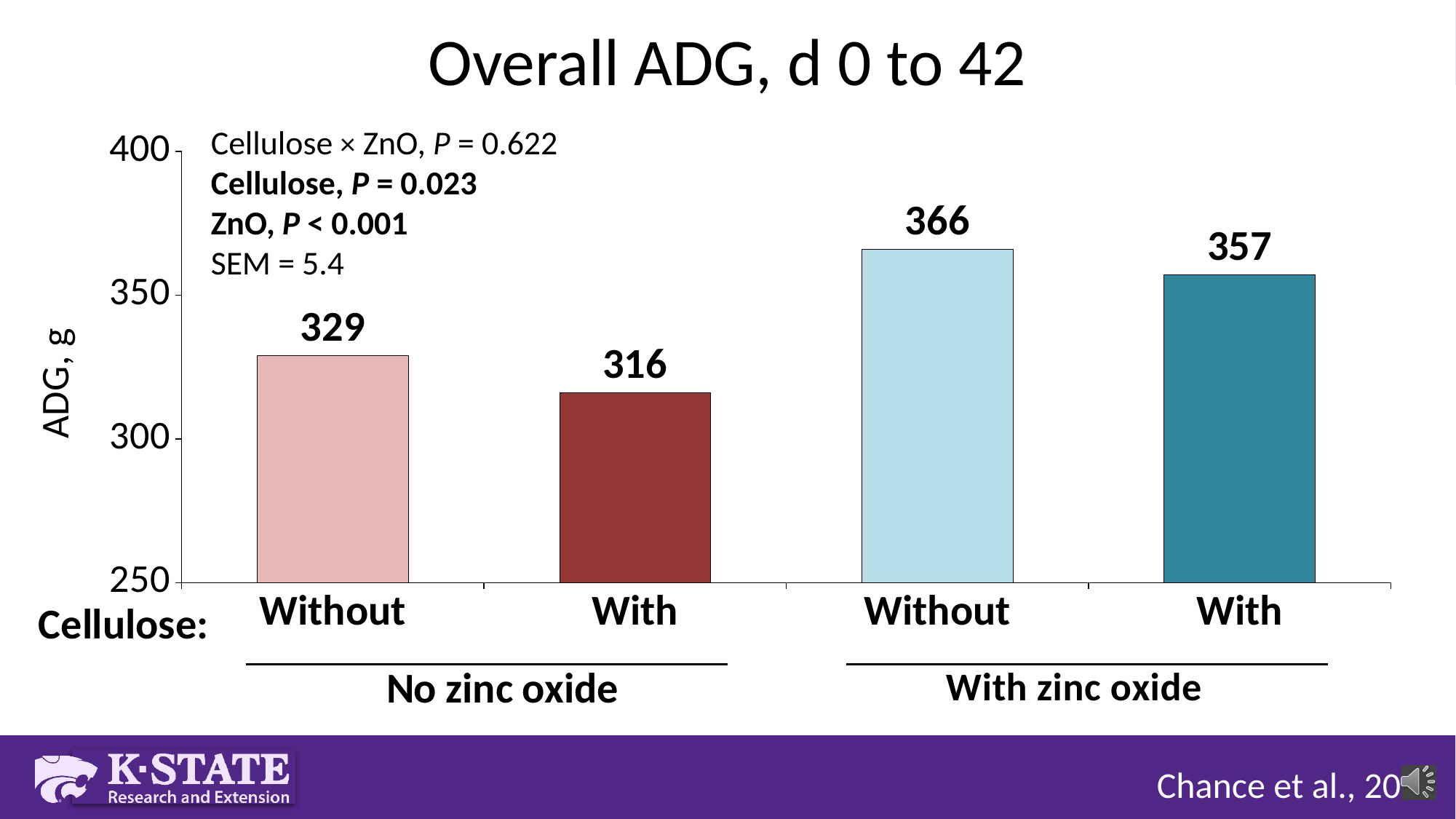
What is the difference in ADG between the Without and With cellulose groups under with zinc oxide? 9 How many bars are shown in the chart? 4 What kind of chart is shown on the slide? Bar chart Which bar has the highest ADG? Without cellulose, with zinc oxide Which bar has the lowest ADG? With cellulose, no zinc oxide What is the difference in ADG between the Without and With cellulose groups under no zinc oxide? 13 What is the ADG for the Without cellulose group with no zinc oxide? 329 What is the ADG for the With cellulose group with no zinc oxide? 316 What is the title of the chart? Overall ADG, d 0 to 42 What is the ADG for the With cellulose group with zinc oxide? 357 What is the ADG for the Without cellulose group with zinc oxide? 366 Which is larger: the ADG for With cellulose with zinc oxide or Without cellulose with no zinc oxide? With cellulose with zinc oxide